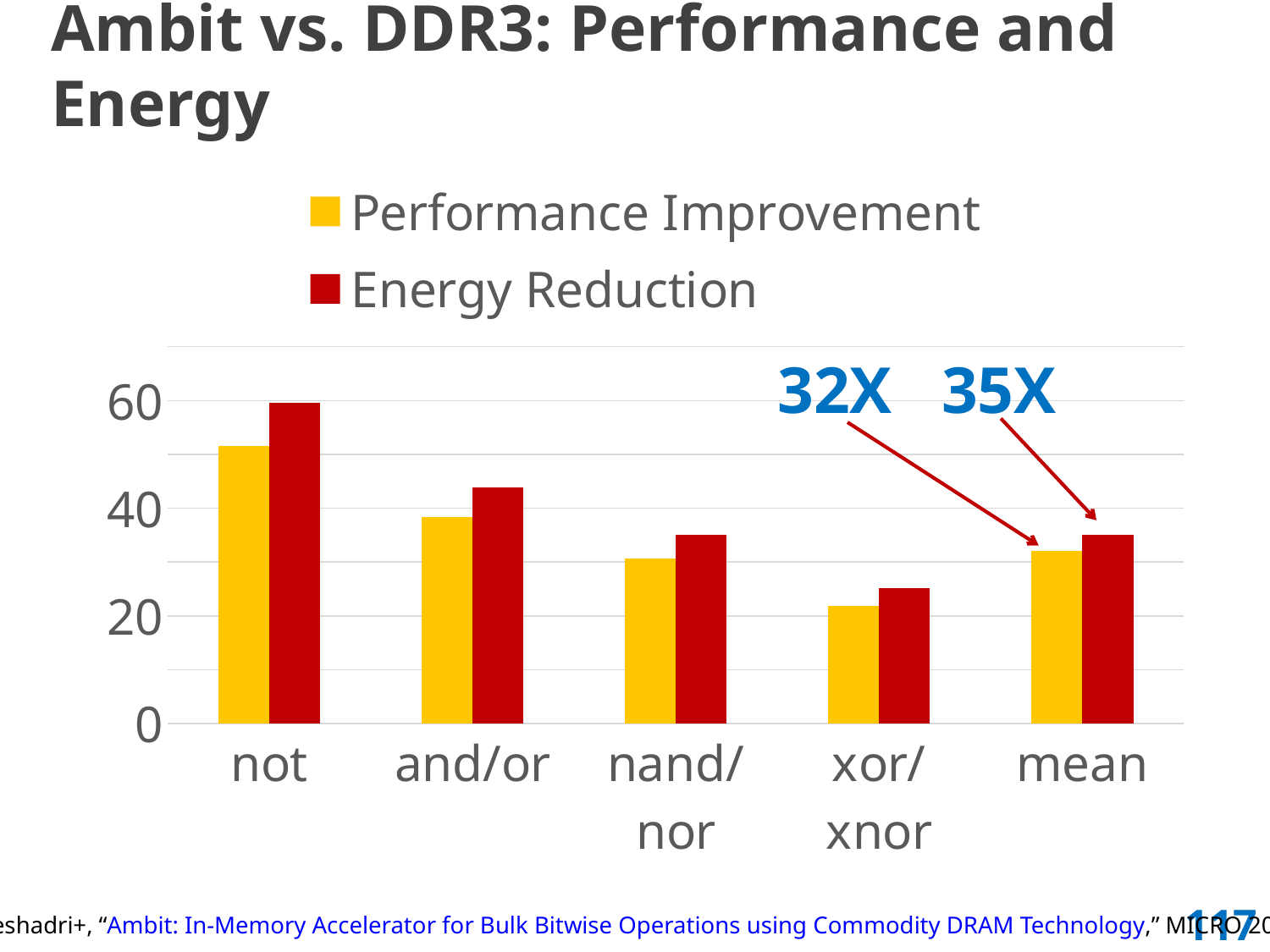
How many categories are shown on the x axis? 5 Is the Energy Reduction value for nand/nor greater or less than 40? less What is the Performance Improvement value for the mean category? 32X What kind of chart is shown on the slide? bar chart How many series does the legend list? 2 Which has a larger Performance Improvement, not or and/or? not Which category has the lowest Energy Reduction? xor/xnor What is the Energy Reduction value for the mean category? 35X Does the Performance Improvement rise or fall from not to xor/xnor? fall What is the difference between the Energy Reduction and Performance Improvement values for the mean category? 3X Is the Energy Reduction value for not greater or less than 40? greater Which category has the highest Performance Improvement? not